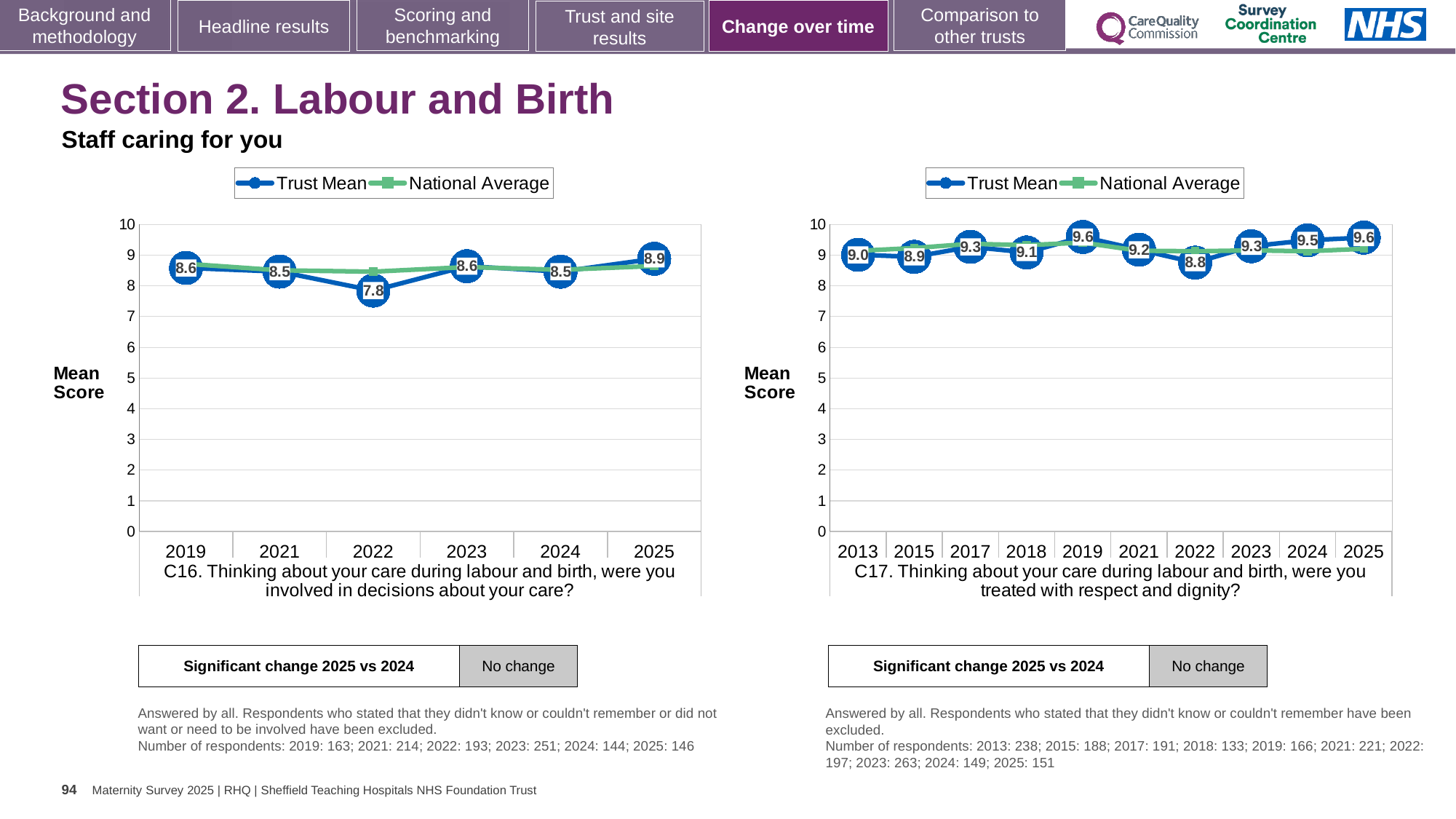
What type of chart is the C16 chart (left)? Line chart In the C17 chart (right), what is the Trust Mean score for 2022? 8.8 In the C17 chart (right), which year has the lowest Trust Mean score? 2022 In the C16 chart (left), what is the difference between the Trust Mean scores for 2025 and 2024? 0.4 In the C16 chart (left), what is the Trust Mean score for 2025? 8.9 In the C17 chart (right), what is the Trust Mean score for 2013? 9.0 In the C16 chart (left), how many years are plotted on the x axis? 6 In the C16 chart (left), what is the Trust Mean score for 2022? 7.8 In the C17 chart (right), how many years are plotted on the x axis? 10 In the C16 chart (left), which year has the lowest Trust Mean score? 2022 In the C17 chart (right), is the Trust Mean score for 2019 or 2021 larger? 2019 How many series does the legend of the C17 chart (right) list? 2